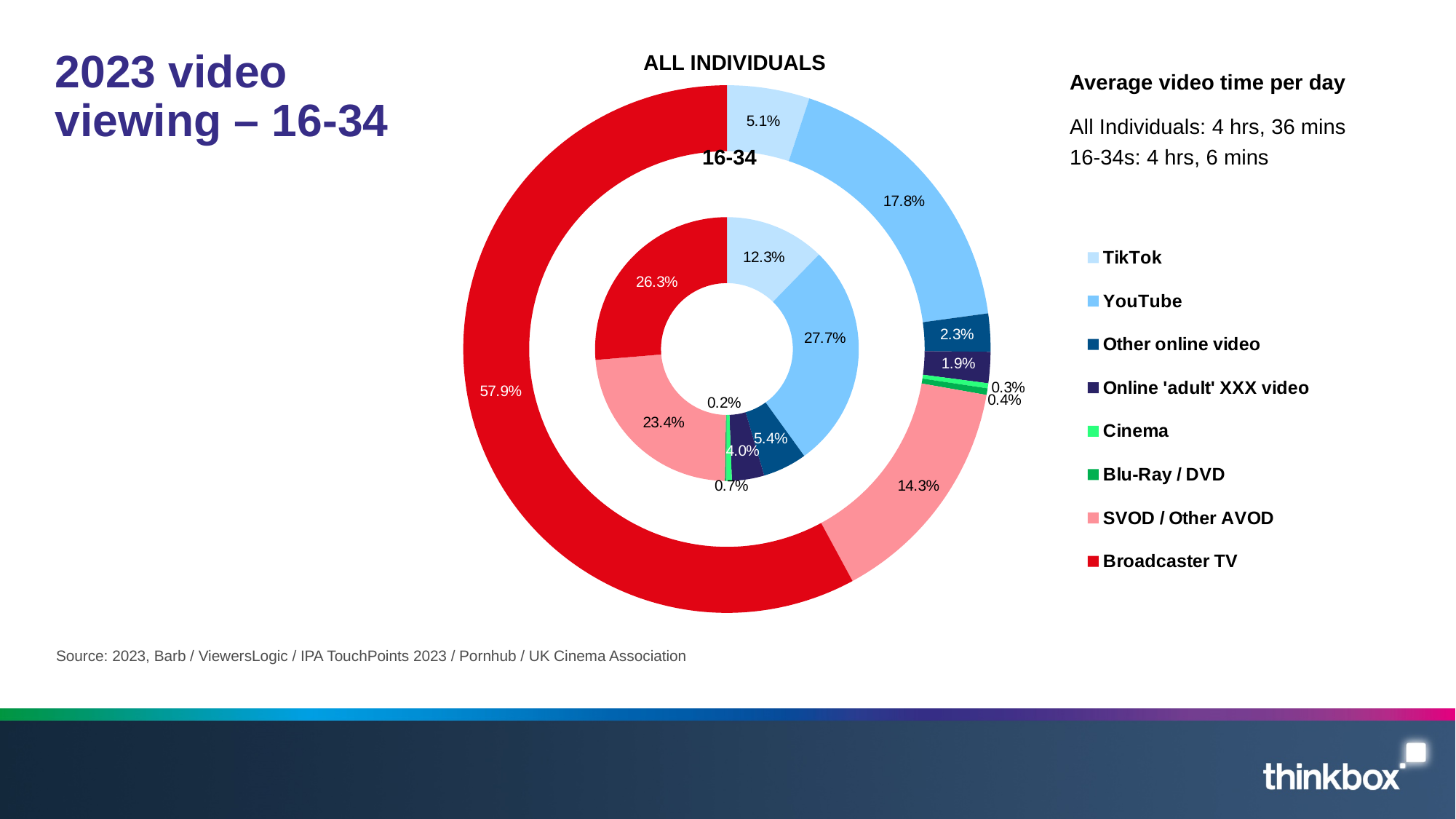
How many rings (series) does the doughnut chart show? 2 What is the SVOD / Other AVOD share in the ALL INDIVIDUALS (outer) ring? 14.3% What type of chart is shown on the slide? Doughnut chart What is the TikTok share in the 16-34 (inner) ring? 12.3% What share of video viewing does Broadcaster TV account for in the ALL INDIVIDUALS (outer) ring? 57.9% How many categories does the legend list? 8 Which category has the largest share in the ALL INDIVIDUALS (outer) ring? Broadcaster TV What share of video viewing does YouTube account for in the 16-34 (inner) ring? 27.7% Which is larger: the TikTok share for 16-34s or the TikTok share for ALL INDIVIDUALS? 16-34s Which category has the largest share in the 16-34 (inner) ring? YouTube How much larger is the Broadcaster TV share for ALL INDIVIDUALS (57.9%) than for 16-34s (26.3%)? 31.6 percentage points Which ring of the doughnut chart represents ALL INDIVIDUALS, the inner or the outer? Outer